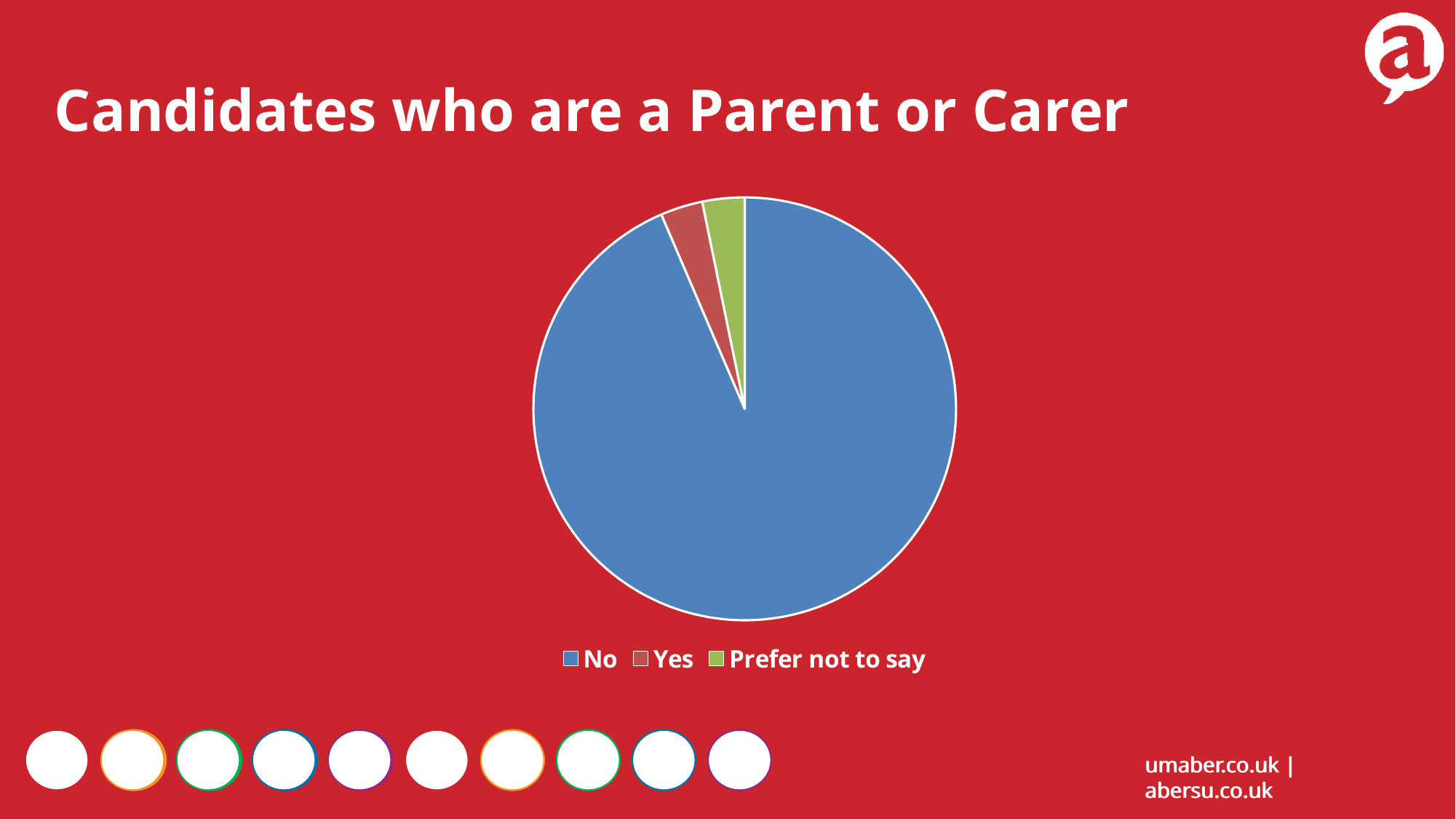
What colour is the slice for No? Blue Which is larger, the slice for No or the slice for Yes? No What is the title of the chart on the slide? Candidates who are a Parent or Carer How many entries does the legend list? 3 Which is larger, the slice for No or the slice for Prefer not to say? No How many categories does the pie chart show? 3 What kind of chart is shown on the slide? Pie chart Which category is shown in green? Prefer not to say Which category has the largest slice of the pie? No